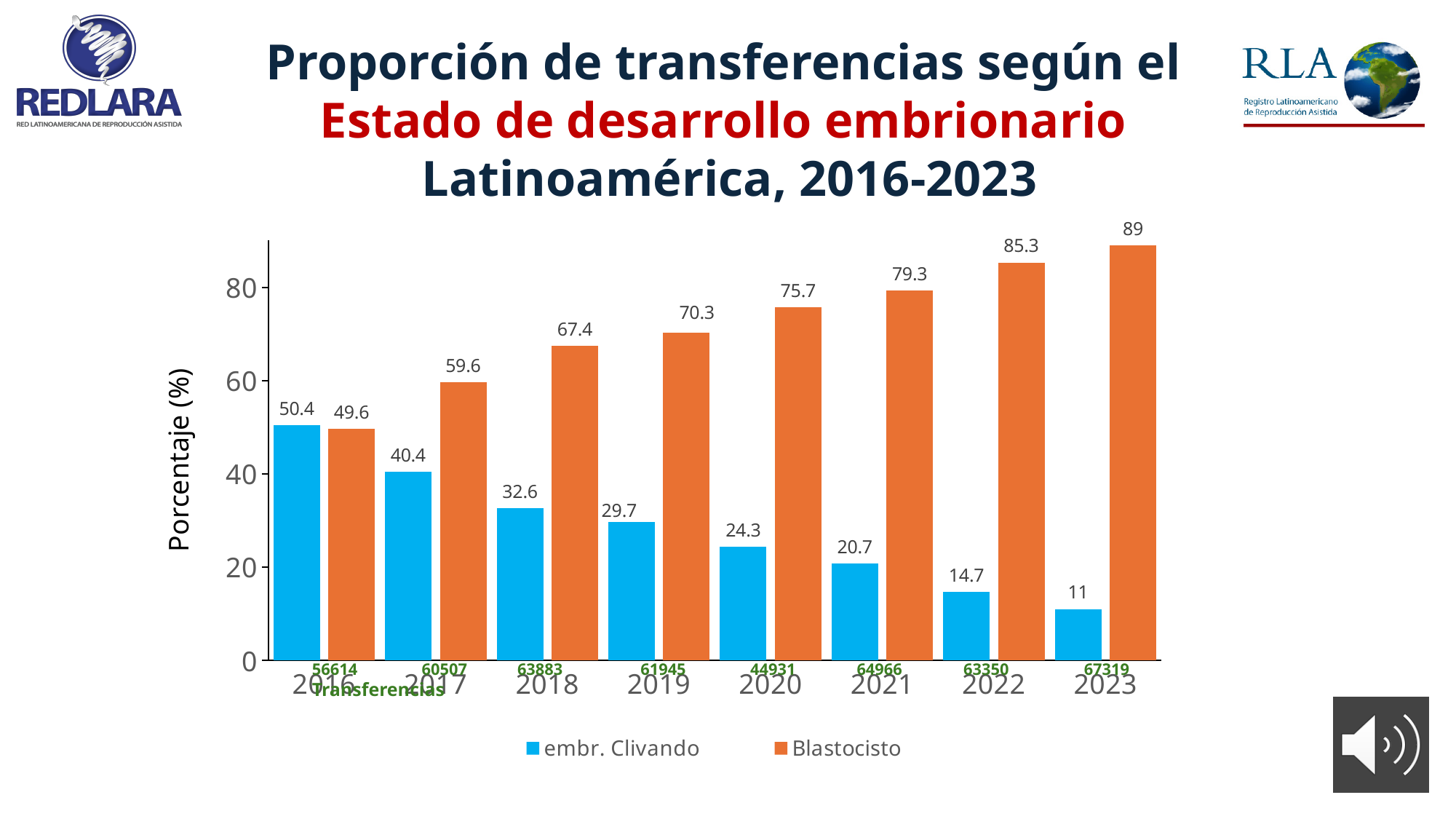
Which year has the lowest value for embr. Clivando? 2023 What is the label of the y axis? Porcentaje (%) Which year has the highest value for Blastocisto? 2023 What is the value for Blastocisto in 2023? 89 What is the value for Blastocisto in 2019? 70.3 Does the embr. Clivando series rise or fall from 2016 to 2023? Fall How many series does the legend list? 2 What is the difference between the Blastocisto and embr. Clivando values in 2021? 58.6 In 2017, which is larger: embr. Clivando or Blastocisto? Blastocisto What kind of chart is shown on the slide? Bar chart How many years are shown on the x axis? 8 What is the value for embr. Clivando in 2016? 50.4